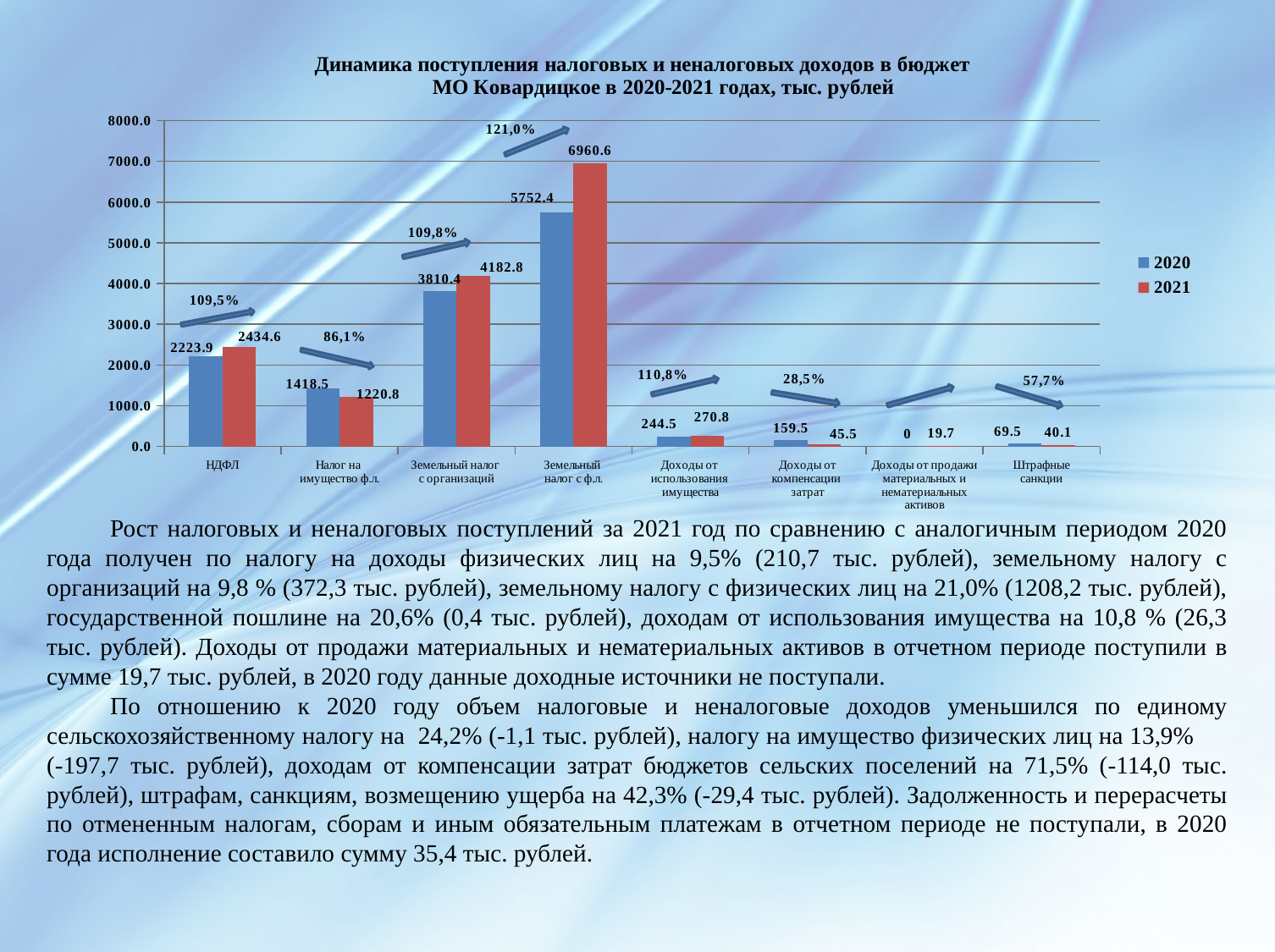
Which category has the lowest 2020 value? Доходы от продажи материальных и нематериальных активов How many series does the legend list? 2 Is the 2020 value for Земельный налог с организаций greater or less than 3000.0? greater What is the 2020 value for Налог на имущество ф.л.? 1418.5 Which category has the highest 2021 value? Земельный налог с ф.л. What is the 2021 value for Земельный налог с ф.л.? 6960.6 What is the 2021 value for Доходы от продажи материальных и нематериальных активов? 19.7 How many categories are shown on the x axis of the chart? 8 What percentage label is shown above the bars for Земельный налог с ф.л.? 121,0% Which is larger for Штрафные санкции, the 2020 value or the 2021 value? 2020 What type of chart is shown on the slide? bar chart What is the difference between the 2021 and 2020 values for НДФЛ? 210.7